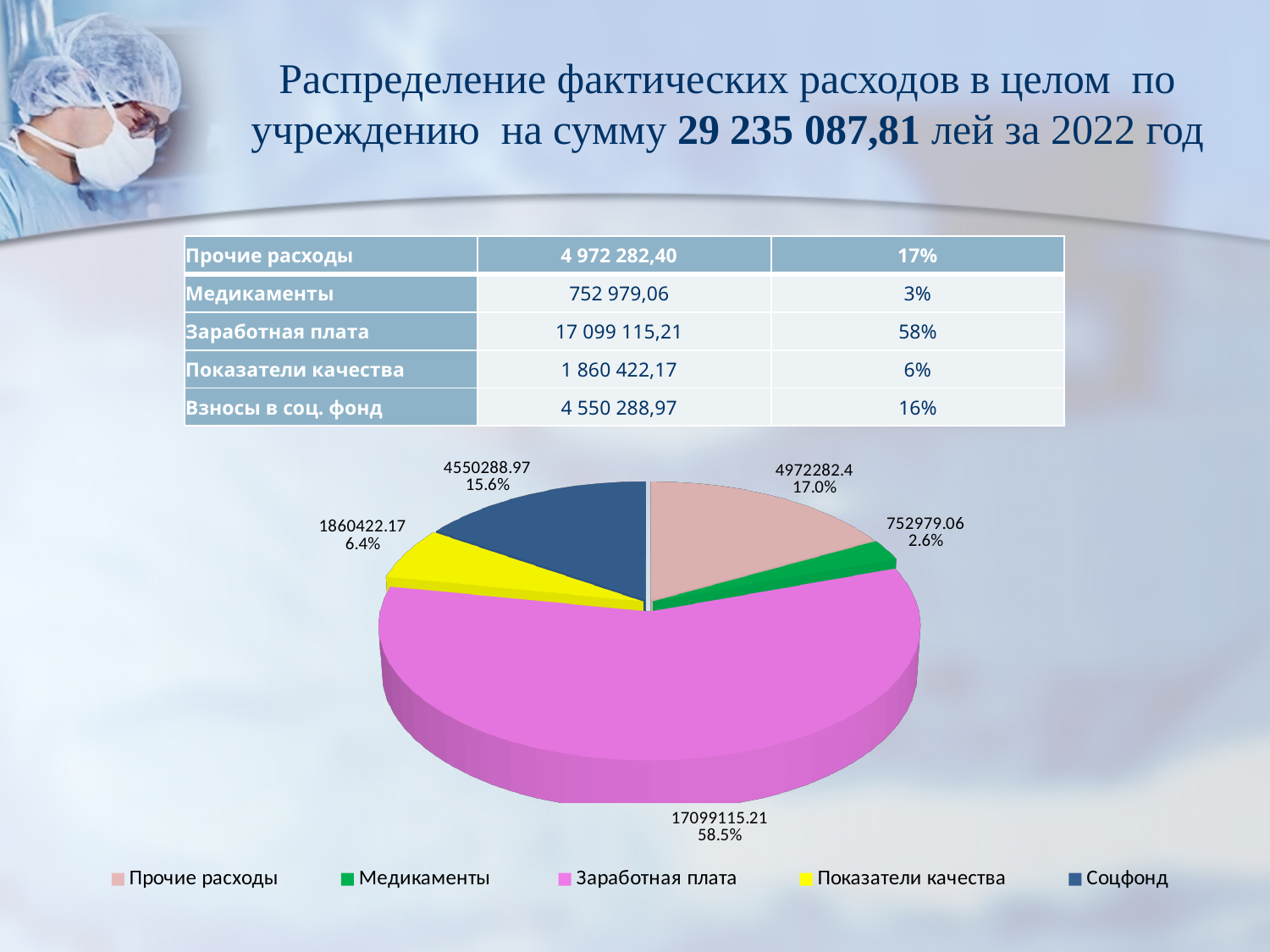
What value is labelled on the pie chart for Заработная плата? 17099115.21 What percentage share of the pie does Показатели качества have? 6.4% What percentage share of the pie does Заработная плата have? 58.5% Which category has the smallest slice in the pie chart? Медикаменты What value is labelled on the pie chart for Соцфонд? 4550288.97 Which is larger in the pie chart, Прочие расходы or Соцфонд? Прочие расходы What value is labelled on the pie chart for Медикаменты? 752979.06 What kind of chart is shown on the slide? pie chart How many entries does the legend of the pie chart list? 5 Which category has the largest slice in the pie chart? Заработная плата What is the difference between the labelled values for Прочие расходы and Соцфонд in the pie chart? 421993.43 How many slices does the pie chart have? 5